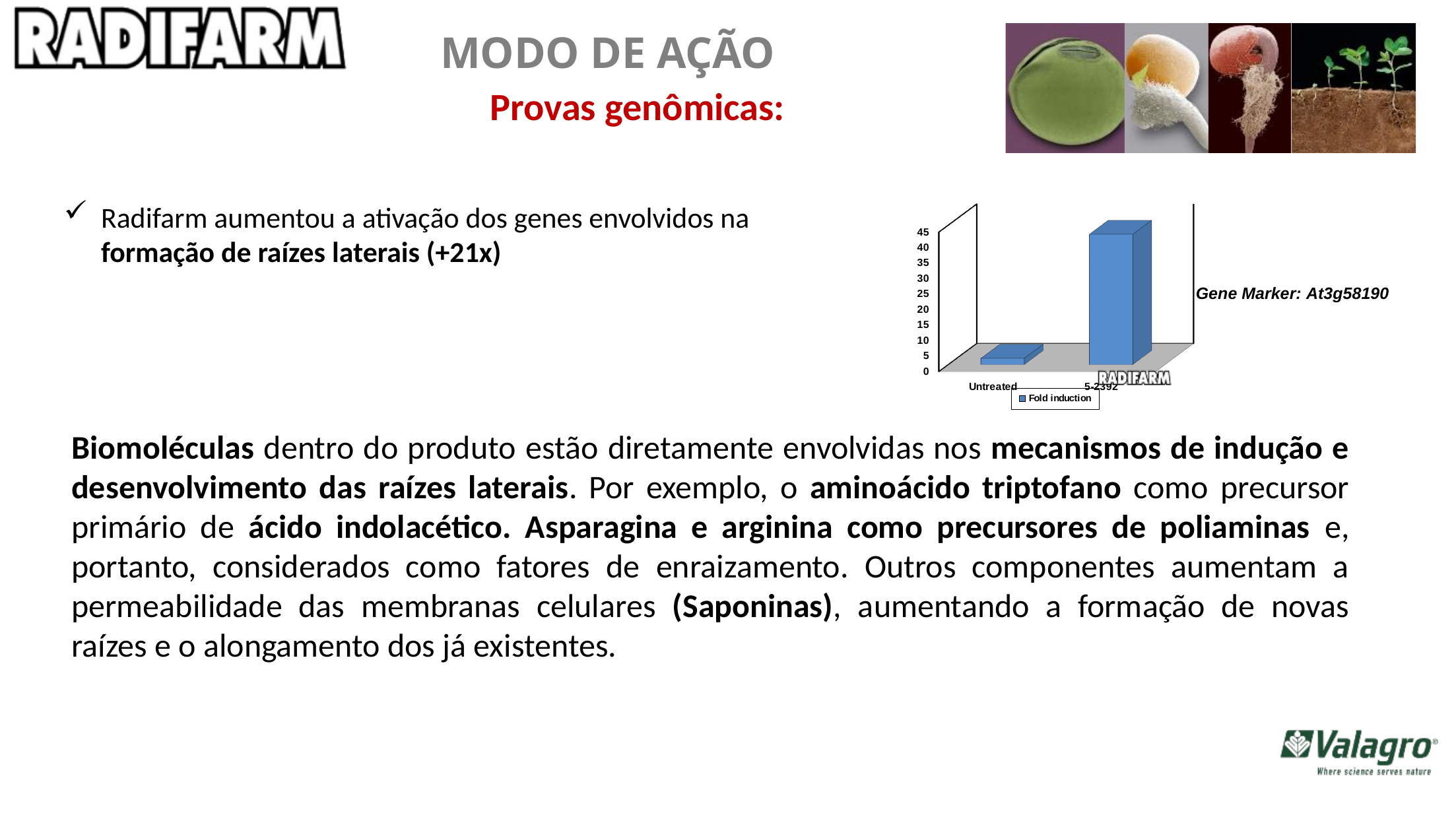
How many bars (categories) does the chart show? 2 Which category has the lowest fold induction in the chart? Untreated What is the highest value shown on the chart's vertical axis? 45 How many series does the chart legend list? 1 Is the fold induction value for Untreated greater or less than 5? less Which category has the highest fold induction in the chart? 5-2392 Which bar is taller, Untreated or 5-2392? 5-2392 What is the name of the series shown in the chart legend? Fold induction Is the fold induction value for 5-2392 greater or less than 35? greater What kind of chart is shown on the slide? bar chart